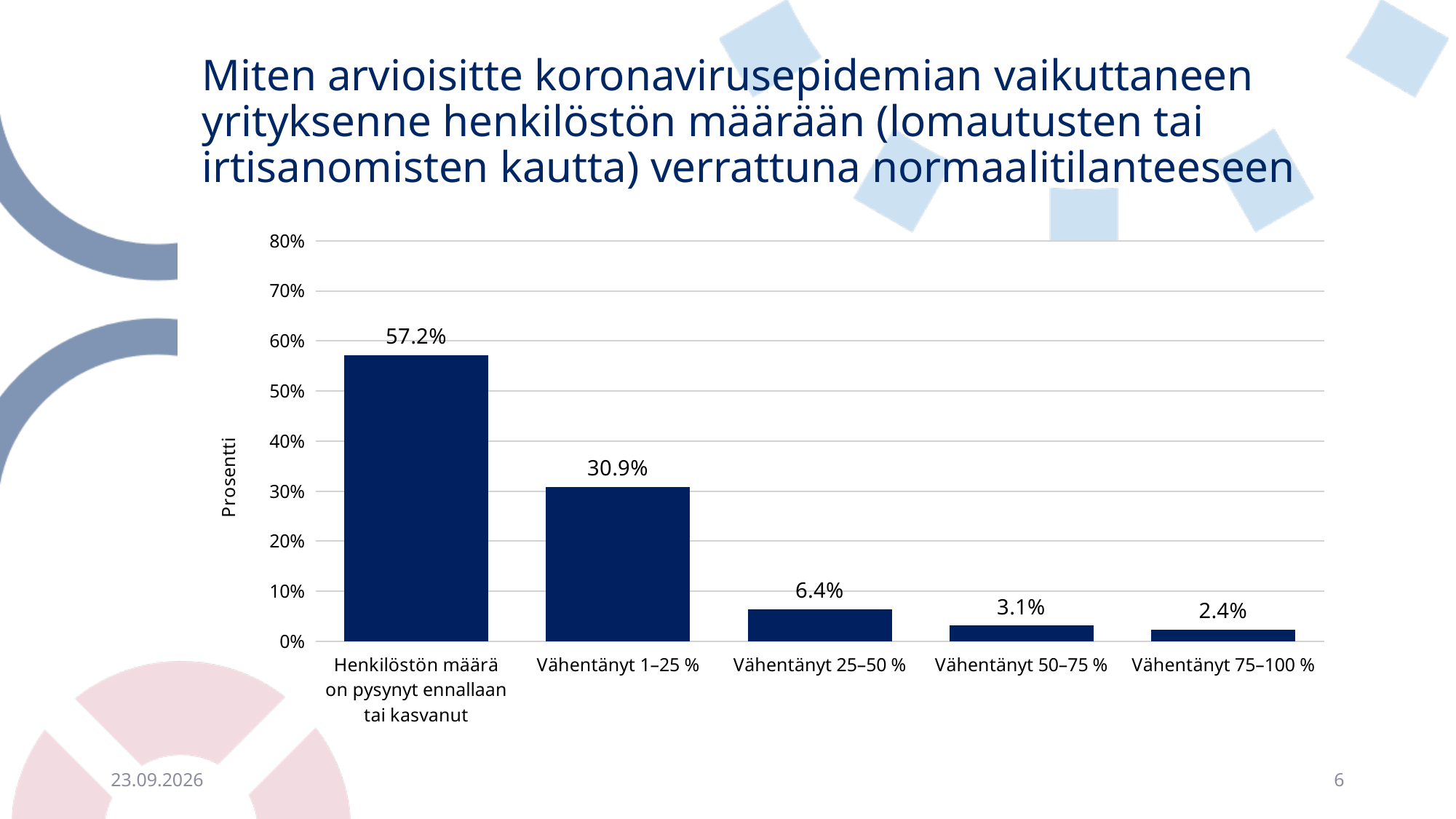
What is the value for "Vähentänyt 25–50 %"? 6.4% Which category has the highest value? Henkilöstön määrä on pysynyt ennallaan tai kasvanut What is the label of the vertical axis? Prosentti What is the value for "Vähentänyt 75–100 %"? 2.4% Which is larger, the value for "Vähentänyt 25–50 %" or "Vähentänyt 50–75 %"? Vähentänyt 25–50 % How many categories are shown on the x axis? 5 What is the value for "Henkilöstön määrä on pysynyt ennallaan tai kasvanut"? 57.2% What kind of chart is shown on the slide? bar chart What is the difference between the values for "Henkilöstön määrä on pysynyt ennallaan tai kasvanut" and "Vähentänyt 1–25 %"? 26.3% Which category has the lowest value? Vähentänyt 75–100 % What is the value for "Vähentänyt 1–25 %"? 30.9% Is the value for "Vähentänyt 1–25 %" greater or less than 40%? less